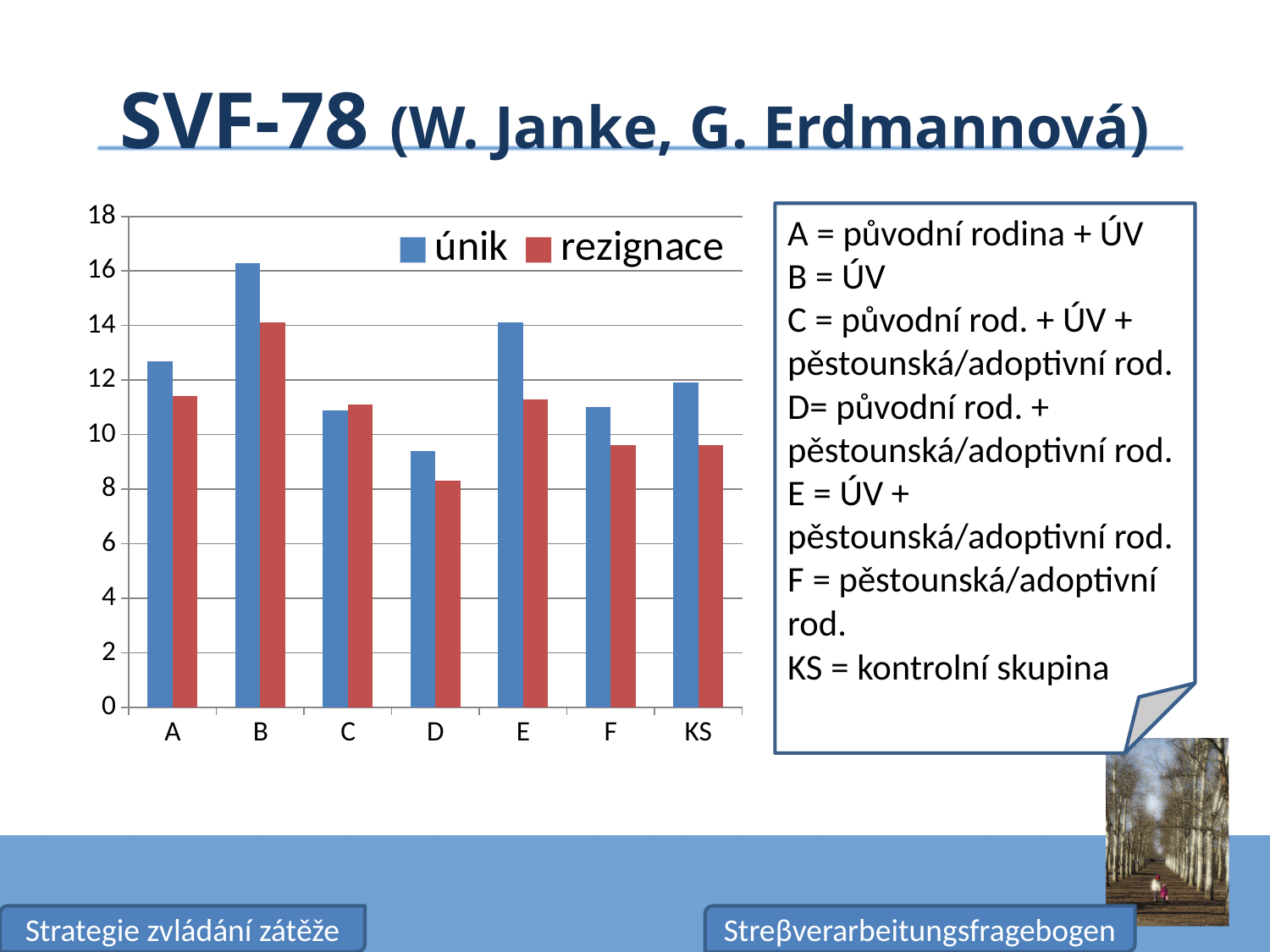
Which category has the highest value for únik? B Which colour represents the rezignace series in the chart? red Is the value for únik in category B greater or less than 14? greater Which category has the lowest value for únik? D Which category has the lowest value for rezignace? D In category E, which series has the larger value, únik or rezignace? únik How many categories are shown on the x axis of the chart? 7 Which category has the highest value for rezignace? B Is the value for rezignace in category D greater or less than 10? less Is the value for únik in category A greater or less than 12? greater How many series does the chart legend list? 2 What kind of chart is shown on the slide? bar chart